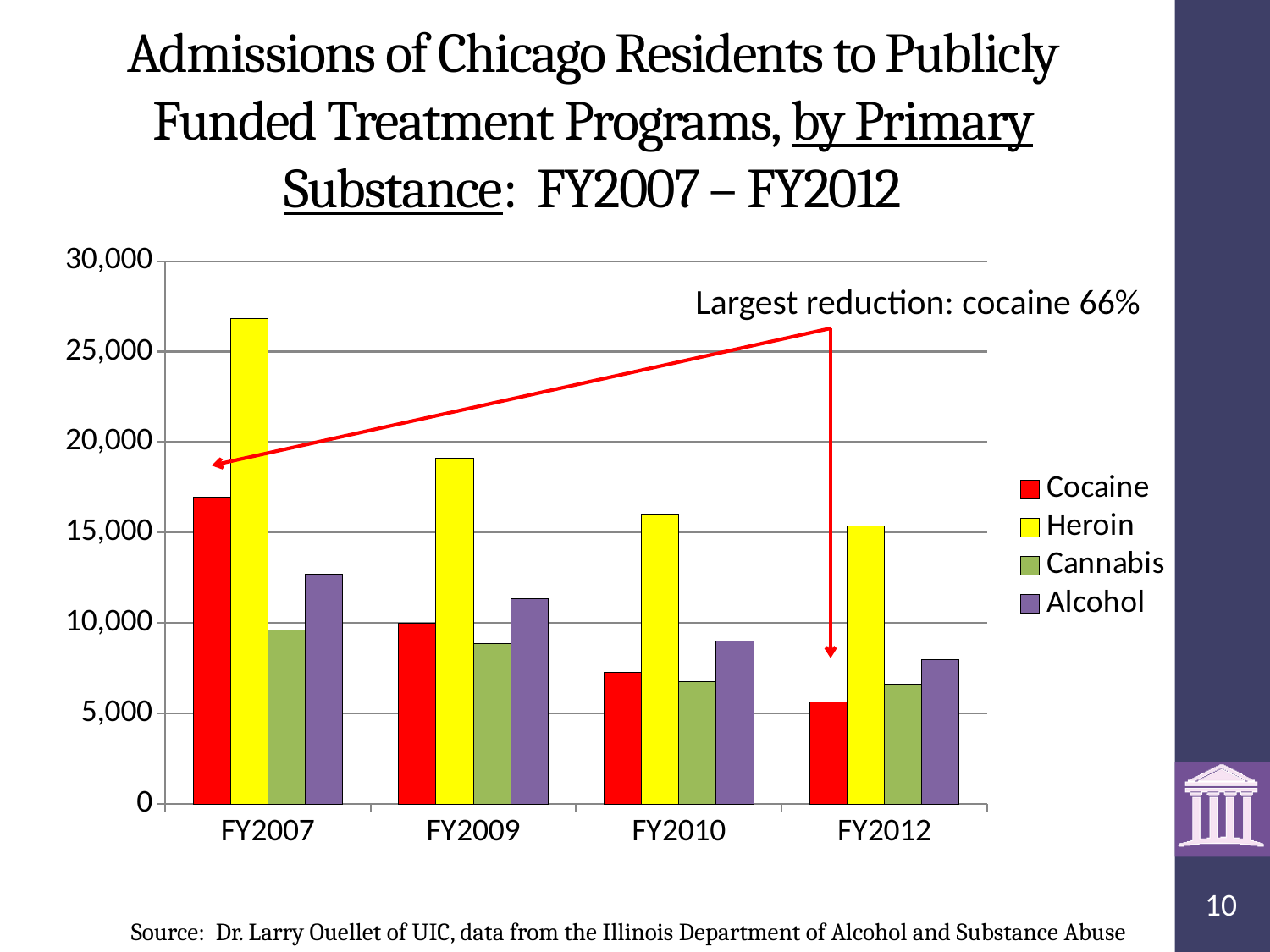
How many fiscal years are shown on the x axis? 4 Do Heroin admissions rise or fall from FY2007 to FY2012? Fall In FY2007, which is larger: Cocaine admissions or Alcohol admissions? Cocaine How many series does the legend list? 4 Which primary substance had the lowest admissions in FY2012? Cocaine What kind of chart is shown on the slide? Bar chart Is the value for Heroin in FY2007 greater or less than 25,000? greater What colour represents Heroin in the chart? Yellow Is the value for Alcohol in FY2007 greater or less than 10,000? greater What does the annotation on the chart say was the largest reduction? Cocaine 66% Which primary substance had the highest admissions in FY2007? Heroin Is the value for Cocaine in FY2012 greater or less than 10,000? less